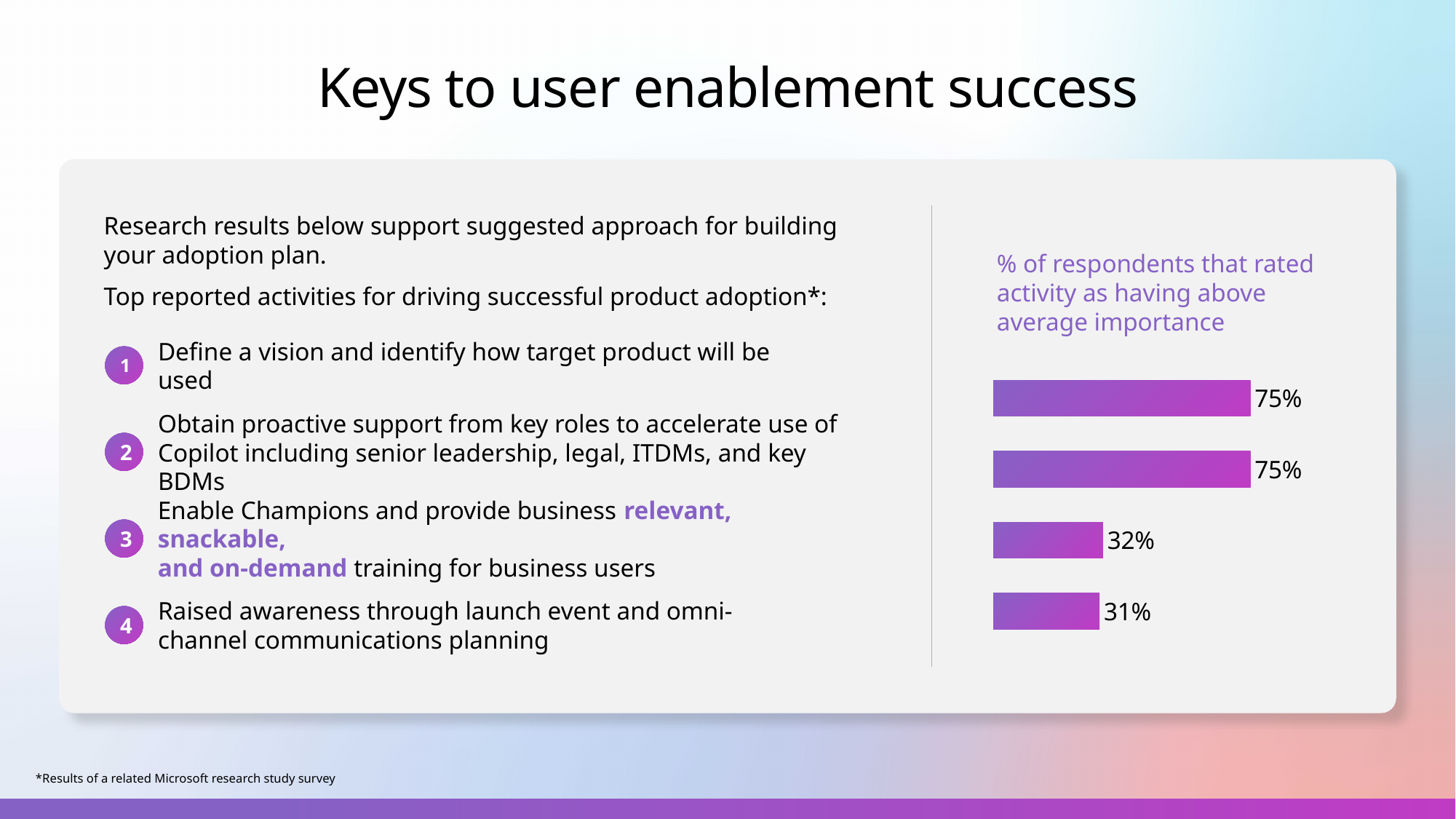
What is the highest value shown in the chart? 75% What is the title of the chart on the right? % of respondents that rated activity as having above average importance How many bars does the chart on the right show? 4 What value is labelled on the third bar from the top of the chart? 32% What kind of chart is shown on the right side of the slide? Bar chart Do the bar values increase or decrease going from the top bar to the bottom bar? Decrease Which is larger, the value of the third bar or the value of the fourth bar? The third bar (32%) What is the difference between the top bar's value and the bottom bar's value? 44 percentage points Which bar in the chart has the lowest value? The bottom bar (31%) What is the difference between the third bar's value and the fourth bar's value? 1 percentage point What value is labelled on the bottom bar of the chart? 31% What value is labelled on the top bar of the chart? 75%